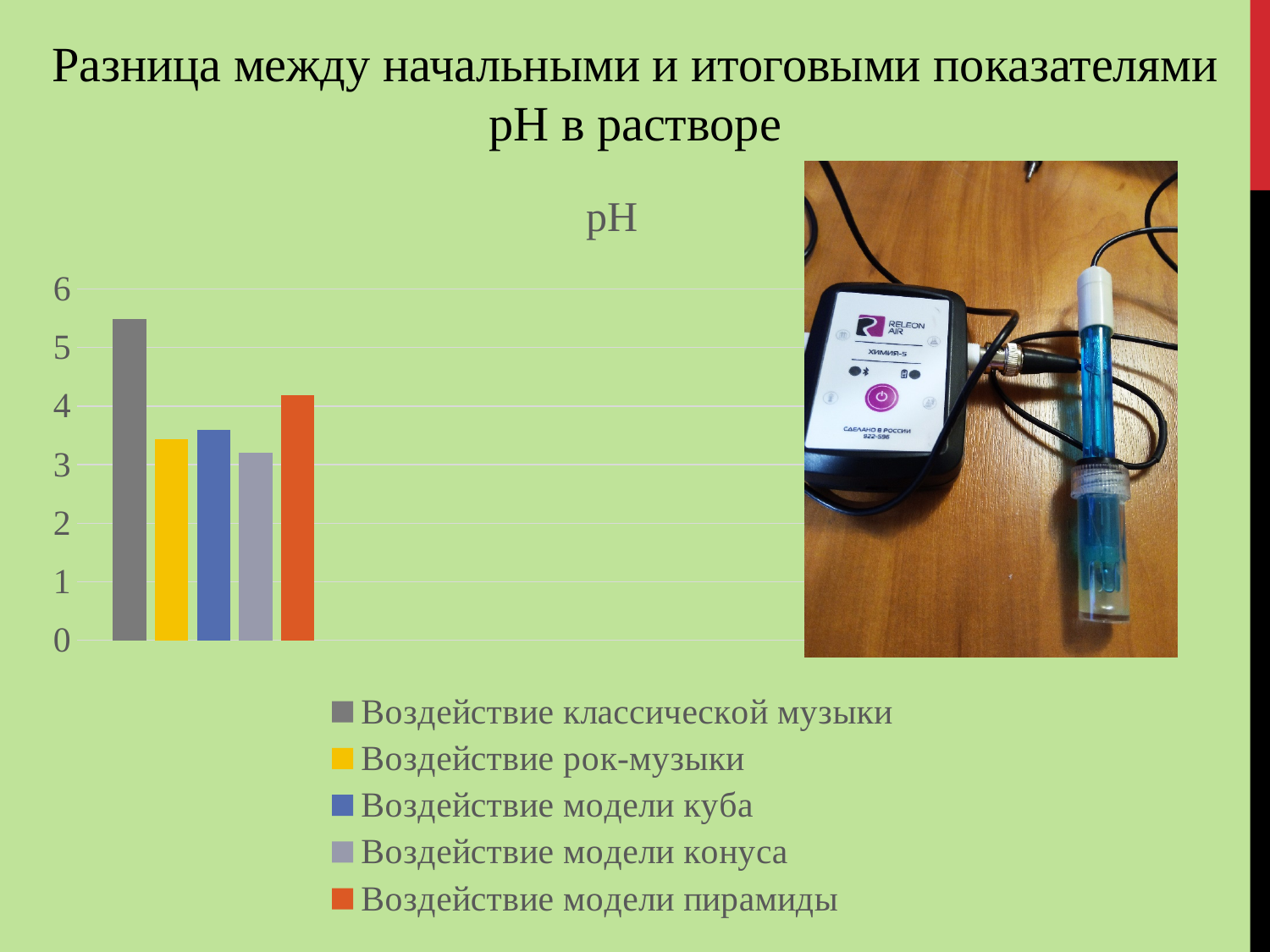
How many bars are plotted in the chart? 5 What is the title of the chart? pH How many series does the legend list? 5 Is the value for Воздействие модели куба greater or less than 4? less Is the value for Воздействие рок-музыки greater or less than 4? less What kind of chart is shown on the slide? bar chart Which is larger, the value for Воздействие классической музыки or the value for Воздействие модели пирамиды? Воздействие классической музыки Which series has the highest pH value? Воздействие классической музыки What colour is the bar for Воздействие модели пирамиды? orange Is the value for Воздействие модели пирамиды greater or less than 5? less Which is larger, the value for Воздействие модели пирамиды or the value for Воздействие модели конуса? Воздействие модели пирамиды